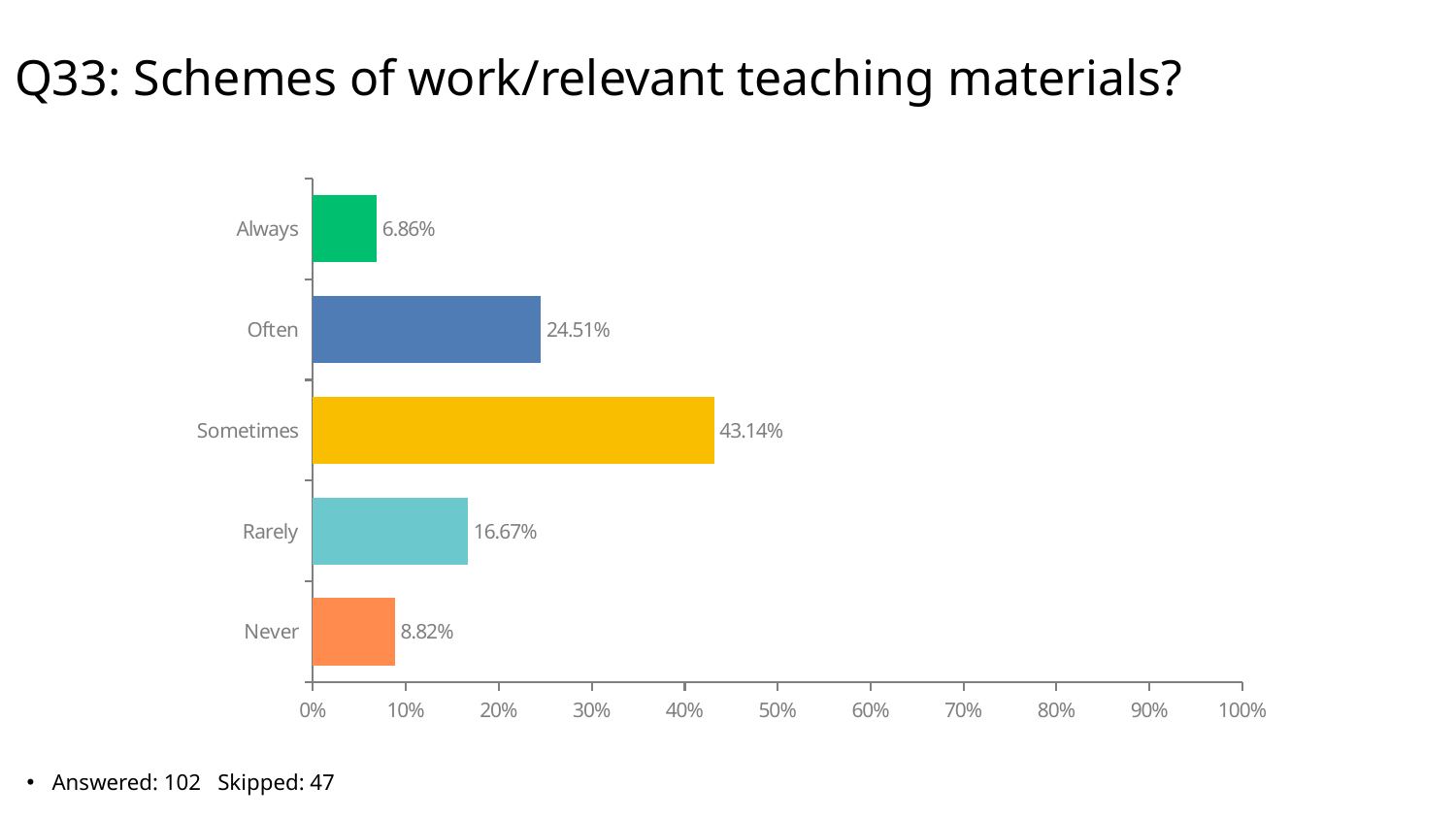
Which is larger, the value for Rarely or the value for Often? Often What kind of chart is shown on the slide? Bar chart What is the difference between the values for Never and Always? 1.96% What is the value for Often? 24.51% Which category has the lowest value? Always What is the difference between the values for Sometimes and Often? 18.63% What is the title of the chart? Q33: Schemes of work/relevant teaching materials? How many categories are shown in the chart? 5 Is the value for Sometimes greater or less than 40%? greater What is the value for Sometimes? 43.14% What is the value for Never? 8.82% Which category has the highest value? Sometimes